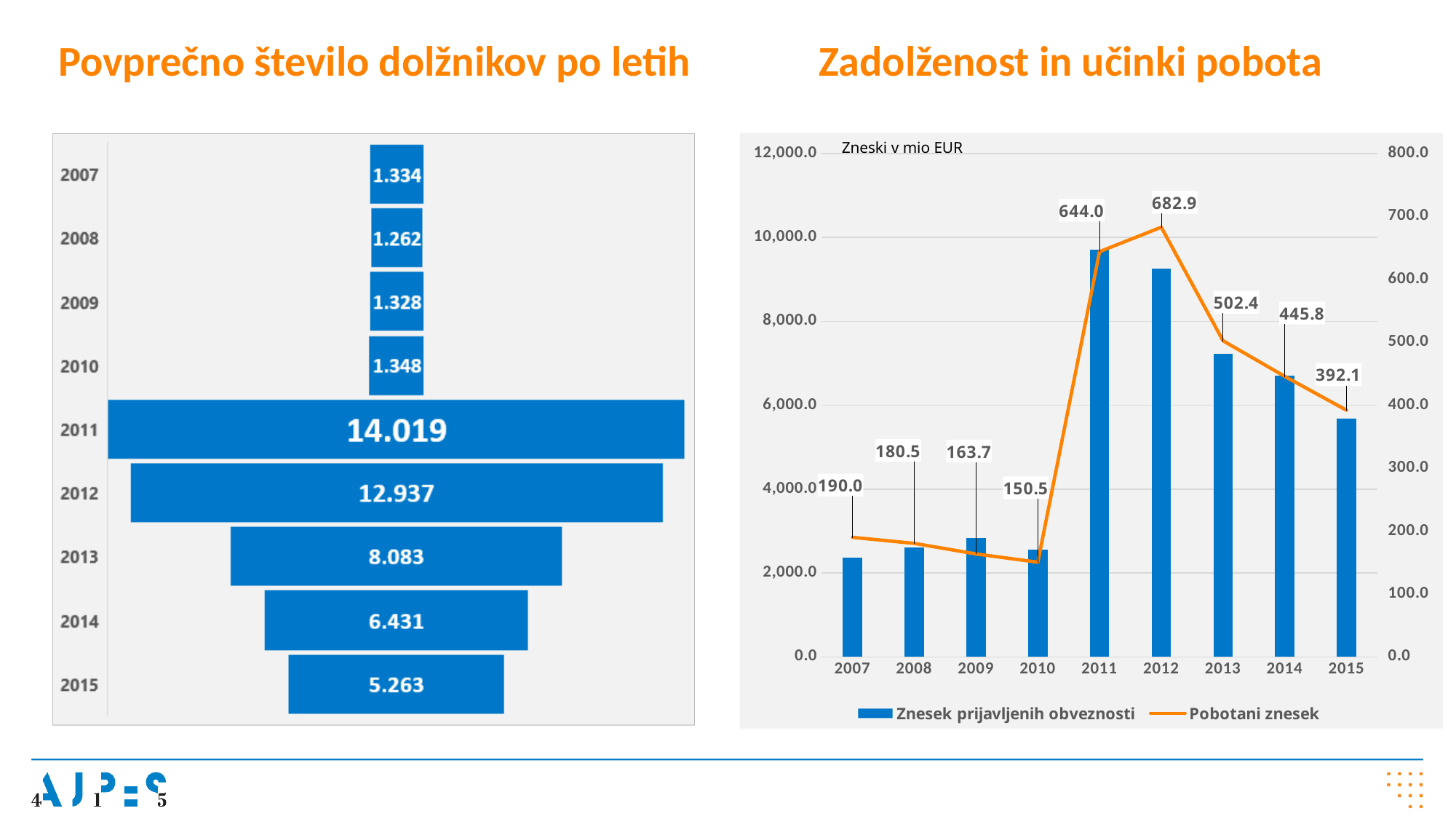
In the chart titled 'Zadolženost in učinki pobota', is the 'Znesek prijavljenih obveznosti' bar for 2011 greater or less than 8,000.0? greater In the chart titled 'Povprečno število dolžnikov po letih', which year has the lowest value? 2008 In the chart titled 'Povprečno število dolžnikov po letih', what is the difference between the values for 2011 and 2012? 1.082 In the chart titled 'Povprečno število dolžnikov po letih', what is the value for 2011? 14.019 In the chart titled 'Zadolženost in učinki pobota', what is the difference between the 'Pobotani znesek' values for 2012 and 2011? 38.9 In the chart titled 'Zadolženost in učinki pobota', what is the value of 'Pobotani znesek' for 2010? 150.5 In the chart titled 'Povprečno število dolžnikov po letih', how many years are shown? 9 In the chart titled 'Povprečno število dolžnikov po letih', which year has the highest value? 2011 In the chart titled 'Zadolženost in učinki pobota', how many series does the legend list? 2 In the chart titled 'Zadolženost in učinki pobota', what is the value of 'Pobotani znesek' for 2012? 682.9 In the chart titled 'Zadolženost in učinki pobota', which year has the lowest 'Pobotani znesek' value? 2010 In the chart titled 'Povprečno število dolžnikov po letih', what is the value for 2015? 5.263